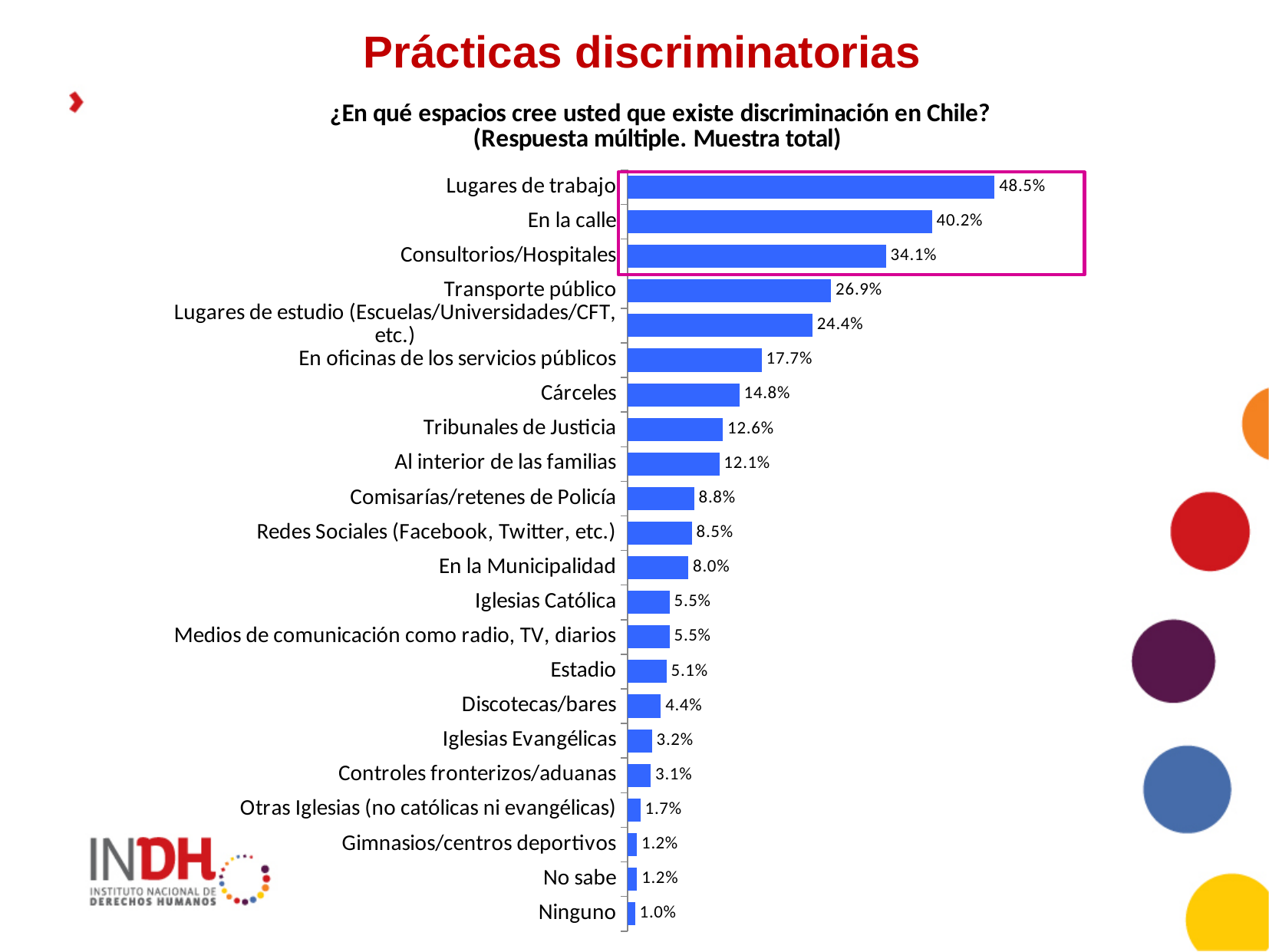
What is the value shown for 'Cárceles'? 14.8% What percentage of respondents said discrimination exists in 'Lugares de trabajo'? 48.5% How many categories are enclosed by the magenta highlight box at the top of the chart? 3 What is the difference between the values for 'Consultorios/Hospitales' and 'Transporte público'? 7.2% What is the value shown for 'Transporte público'? 26.9% Which is larger, the value for 'Tribunales de Justicia' or 'Al interior de las familias'? Tribunales de Justicia What is the difference between the values for 'Lugares de trabajo' and 'En la calle'? 8.3% Which category has the highest value in the chart? Lugares de trabajo Which is larger, the value for 'Comisarías/retenes de Policía' or 'En la Municipalidad'? Comisarías/retenes de Policía How many categories are shown in the chart? 22 What type of chart is shown on the slide? Bar chart Which category has the lowest value in the chart? Ninguno